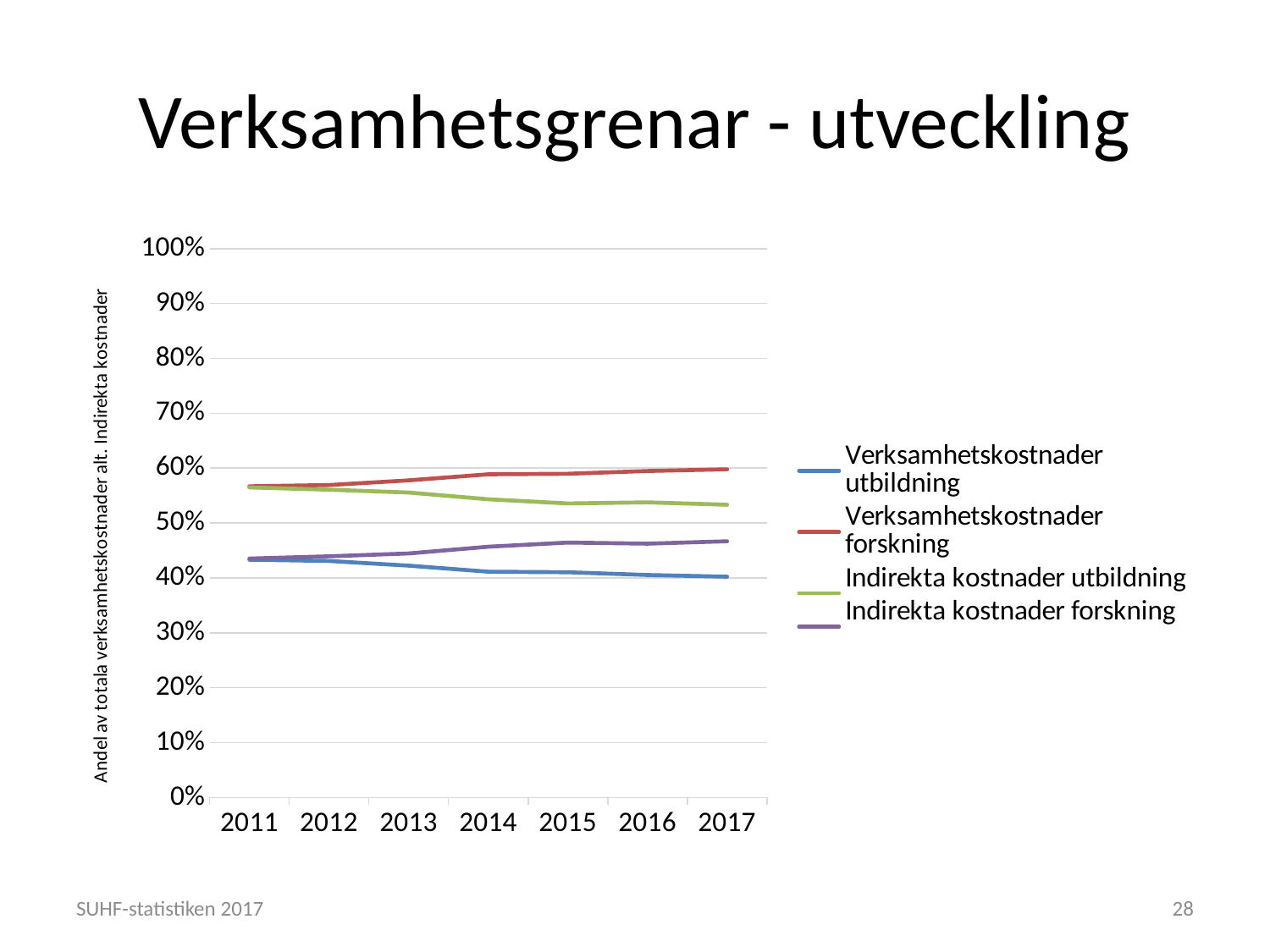
Which series has the highest value in 2017? Verksamhetskostnader forskning Is the value for Verksamhetskostnader forskning in 2017 greater or less than 50%? greater What kind of chart is shown on the slide? Line chart How many series does the legend list? 4 Which series has the lowest value in 2017? Verksamhetskostnader utbildning Does the value for Verksamhetskostnader forskning rise or fall from 2011 to 2017? Rise In 2017, which is higher: Verksamhetskostnader forskning or Indirekta kostnader utbildning? Verksamhetskostnader forskning Is the value for Verksamhetskostnader utbildning in 2017 greater or less than 50%? less What colour is the line for Verksamhetskostnader forskning? Red Does the value for Indirekta kostnader utbildning rise or fall from 2011 to 2017? Fall Does the value for Verksamhetskostnader utbildning rise or fall from 2011 to 2017? Fall How many years are shown on the x axis? 7